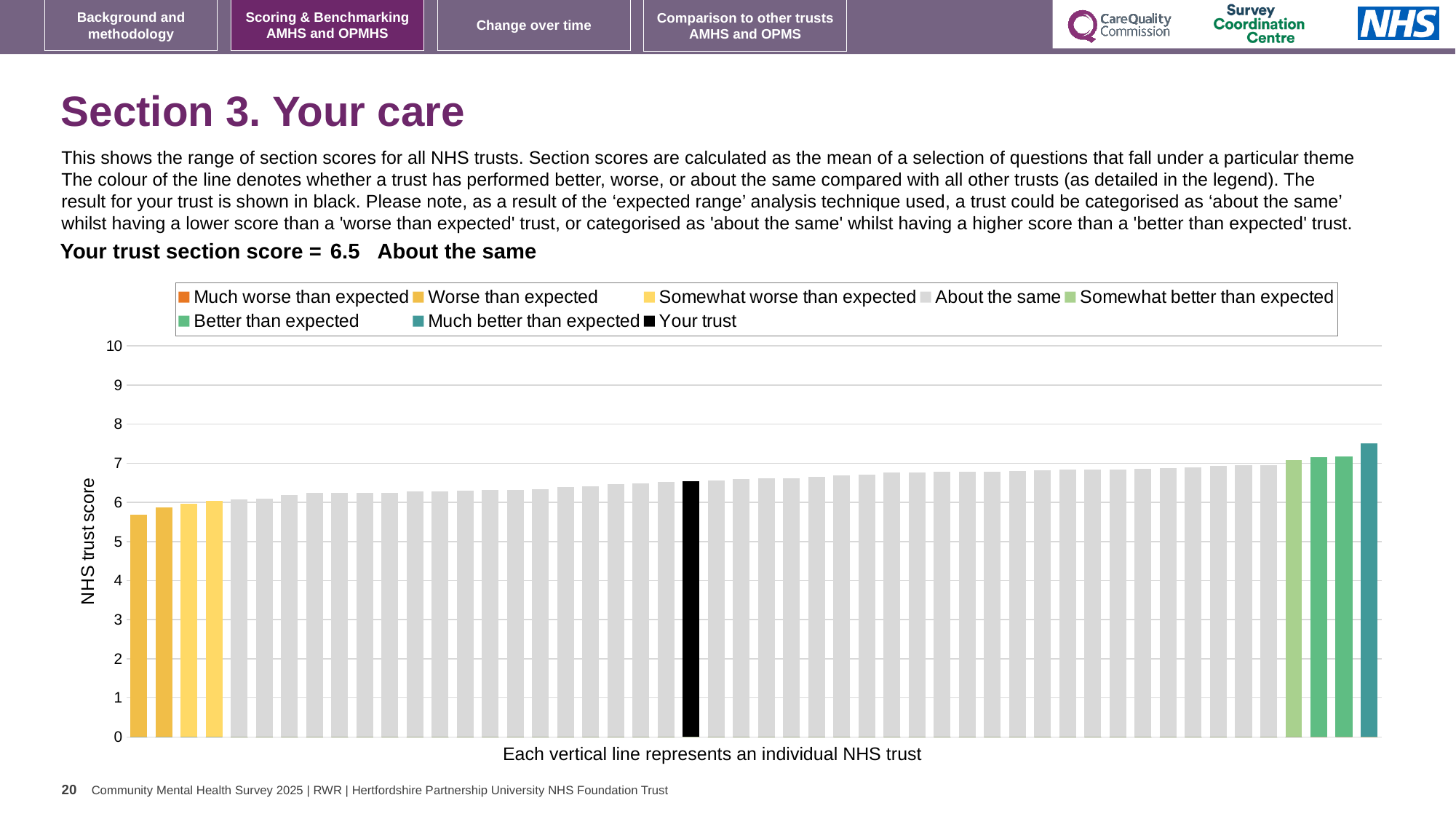
Is the value of the lowest bar greater or less than 6? less Is the value for your trust (the black bar) greater or less than 6? greater Which performance category is your trust placed in for this section? About the same What kind of chart is shown on the slide? bar chart Do the bar values rise or fall from left to right along the x axis? rise What is the title of the vertical axis? NHS trust score What colour is the bar representing your trust? black How many entries does the chart legend list? 8 Is the value for your trust (the black bar) greater or less than 7? less What is the section score for your trust? 6.5 Which legend category does the highest bar on the chart belong to? Much better than expected